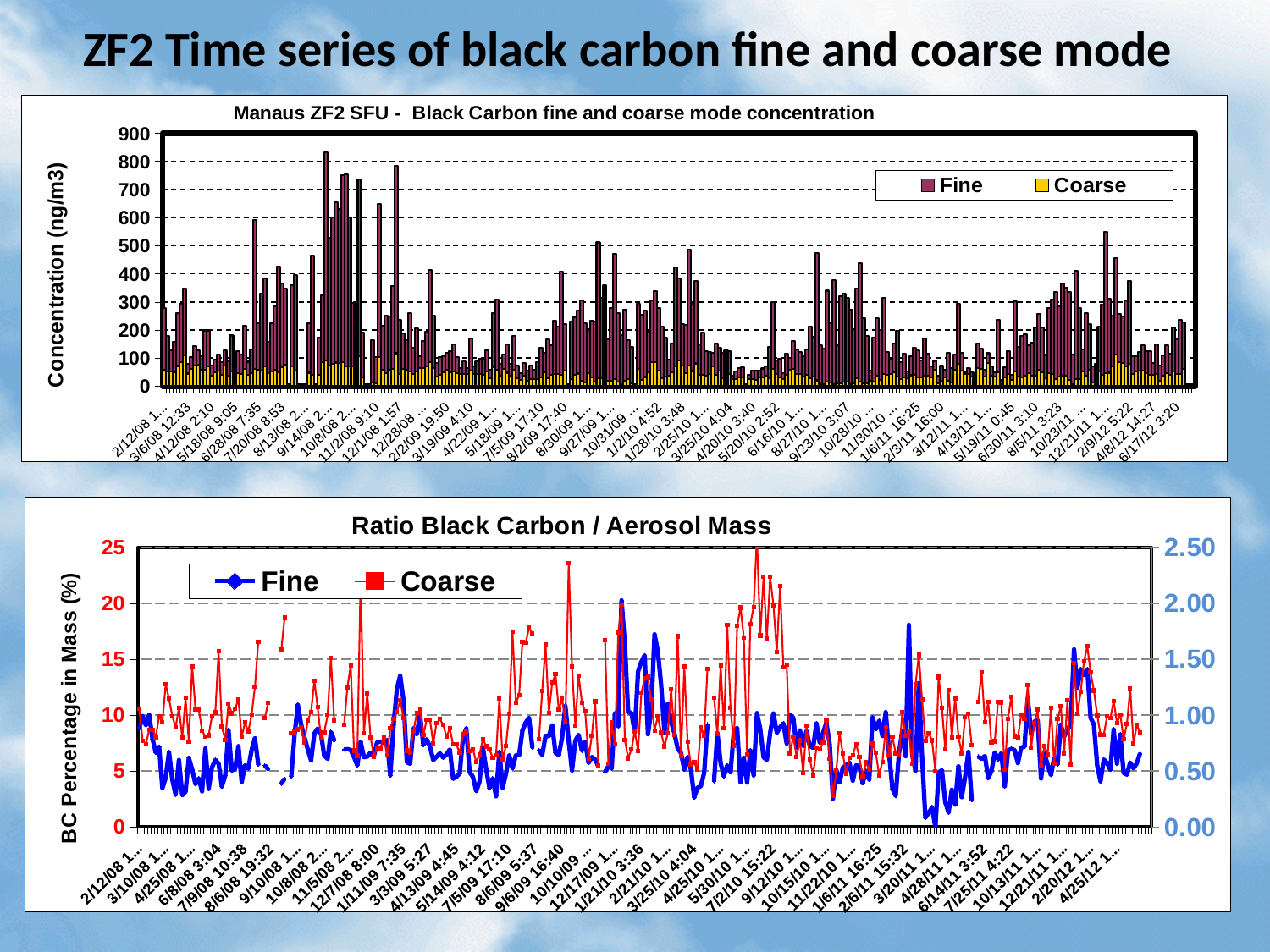
In the bottom chart, what is the maximum value shown on the left vertical axis? 25 In the bottom chart, what is the maximum value shown on the right vertical axis? 2.50 In the top chart, which series generally has the larger values, Fine or Coarse? Fine How many series does the legend of the top chart list? 2 In the top chart, is the tallest Coarse bar greater or less than 200? less What kind of chart is the bottom chart titled "Ratio Black Carbon / Aerosol Mass"? line chart In the top chart, what are the two series named in the legend? Fine and Coarse In the top chart, is the tallest Fine bar greater or less than 700? greater How many series does the legend of the bottom chart list? 2 What kind of chart is the top chart titled "Manaus ZF2 SFU - Black Carbon fine and coarse mode concentration"? bar chart